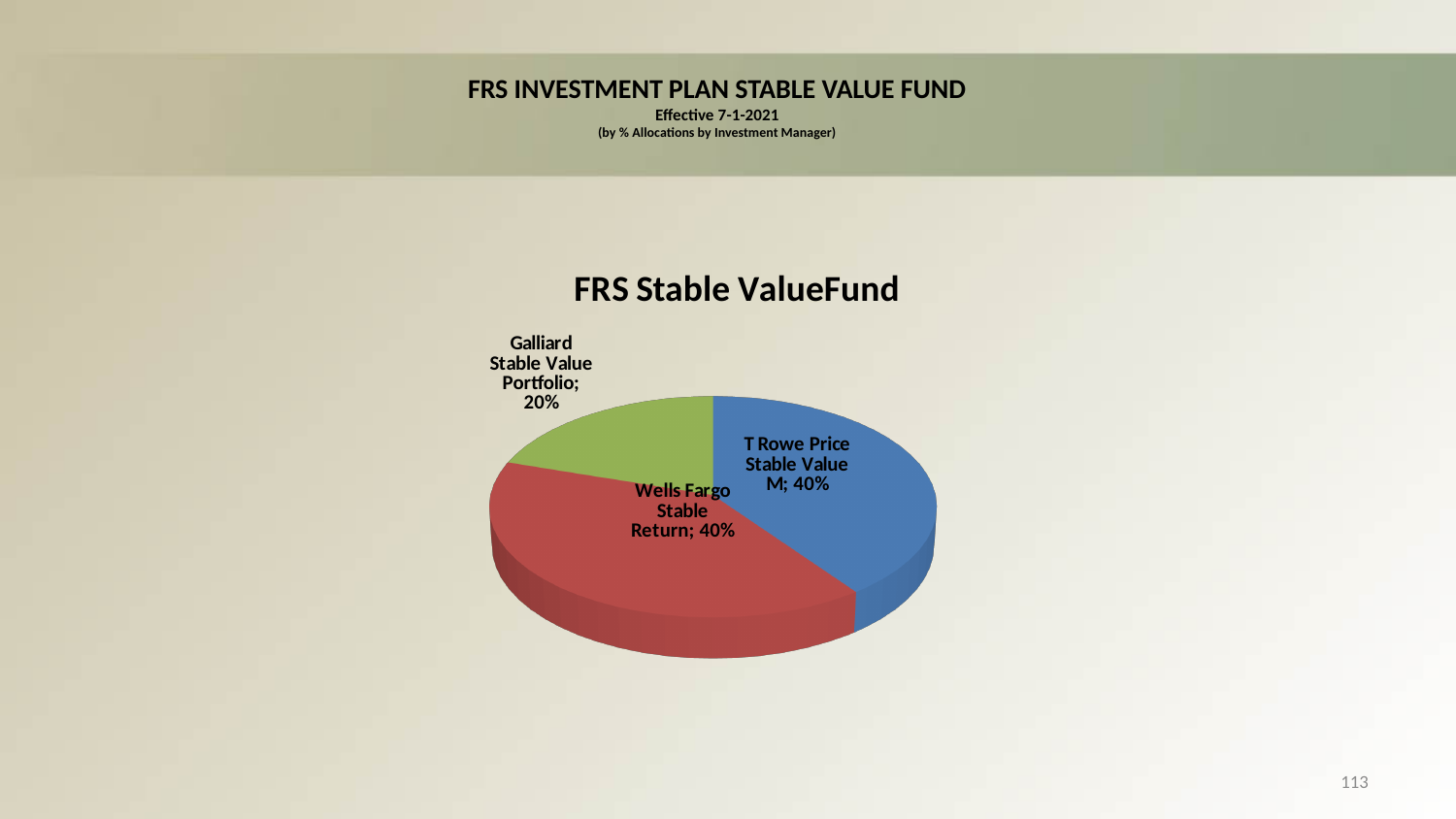
What share of the pie does the Galliard Stable Value Portfolio slice represent? 20% Which investment manager has the smallest allocation in the pie chart? Galliard Stable Value Portfolio What is the title of the pie chart? FRS Stable ValueFund What percentage of the FRS Stable Value Fund is allocated to Galliard Stable Value Portfolio? 20% What percentage of the FRS Stable Value Fund is allocated to T Rowe Price Stable Value M? 40% How many slices does the pie chart have? 3 What kind of chart is shown on the slide? pie chart Which allocation is larger, Galliard Stable Value Portfolio or T Rowe Price Stable Value M? T Rowe Price Stable Value M What is the difference in percentage points between the Wells Fargo Stable Return allocation and the Galliard Stable Value Portfolio allocation? 20 percentage points What colour is the slice for Galliard Stable Value Portfolio? green What percentage of the FRS Stable Value Fund is allocated to Wells Fargo Stable Return? 40%